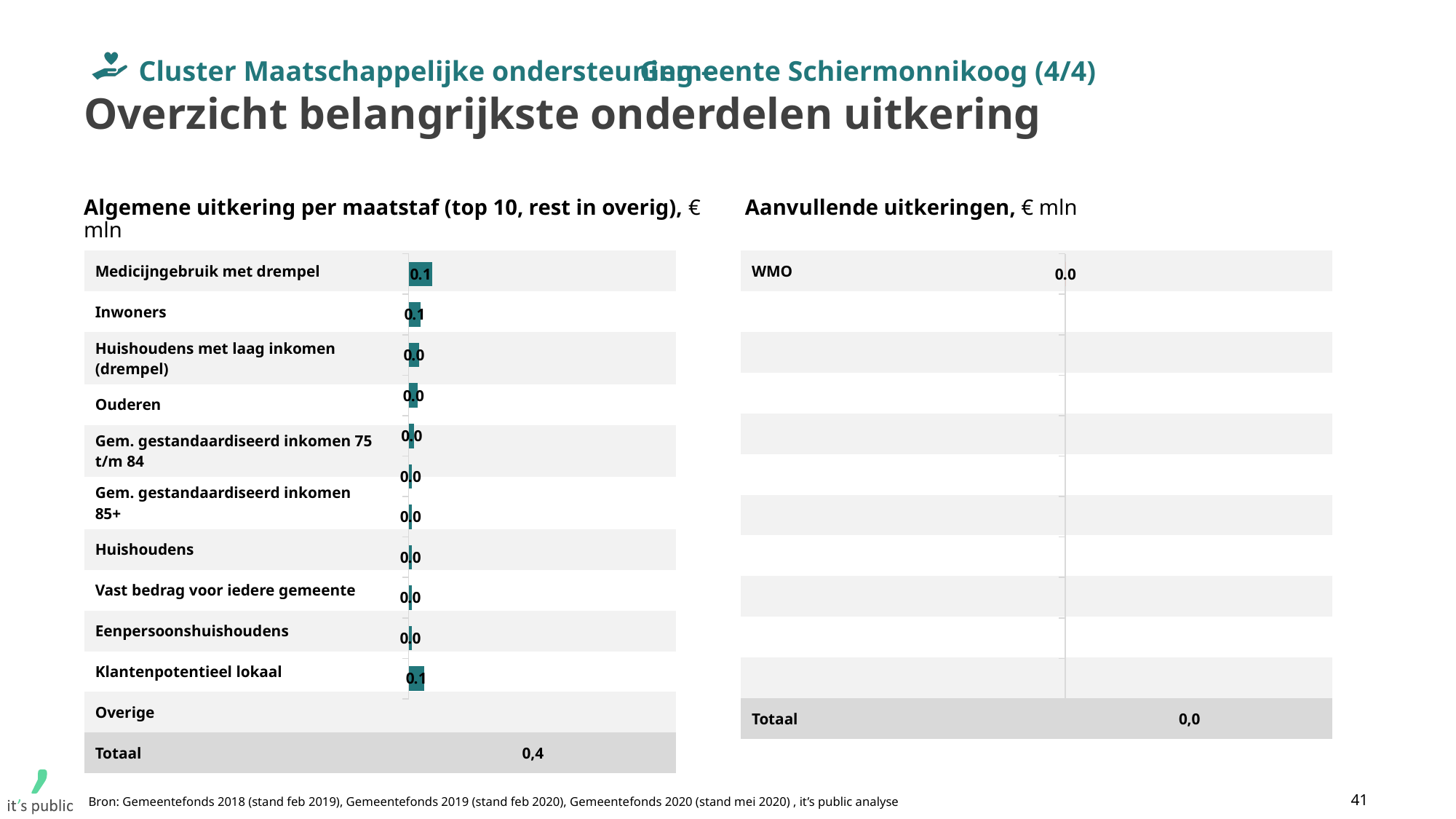
In the 'Algemene uitkering per maatstaf' chart, what is the Totaal value? 0,4 In the 'Algemene uitkering per maatstaf' chart, what is the value for Ouderen? 0.0 In the 'Algemene uitkering per maatstaf' chart, which is larger: Medicijngebruik met drempel or Ouderen? Medicijngebruik met drempel In the 'Algemene uitkering per maatstaf' chart, what is the difference between Medicijngebruik met drempel and Huishoudens? 0.1 How many categories are listed in the 'Aanvullende uitkeringen' chart (excluding Totaal)? 1 In what unit are the values of the 'Aanvullende uitkeringen' chart expressed? € mln In the 'Algemene uitkering per maatstaf' chart, which category has the largest bar? Medicijngebruik met drempel In the 'Aanvullende uitkeringen' chart, what is the Totaal value? 0,0 What kind of chart is shown under 'Algemene uitkering per maatstaf'? bar chart In the 'Algemene uitkering per maatstaf' chart, what is the value for Inwoners? 0.1 In the 'Aanvullende uitkeringen' chart, what is the value for WMO? 0.0 In the 'Algemene uitkering per maatstaf' chart, what is the value for Medicijngebruik met drempel? 0.1